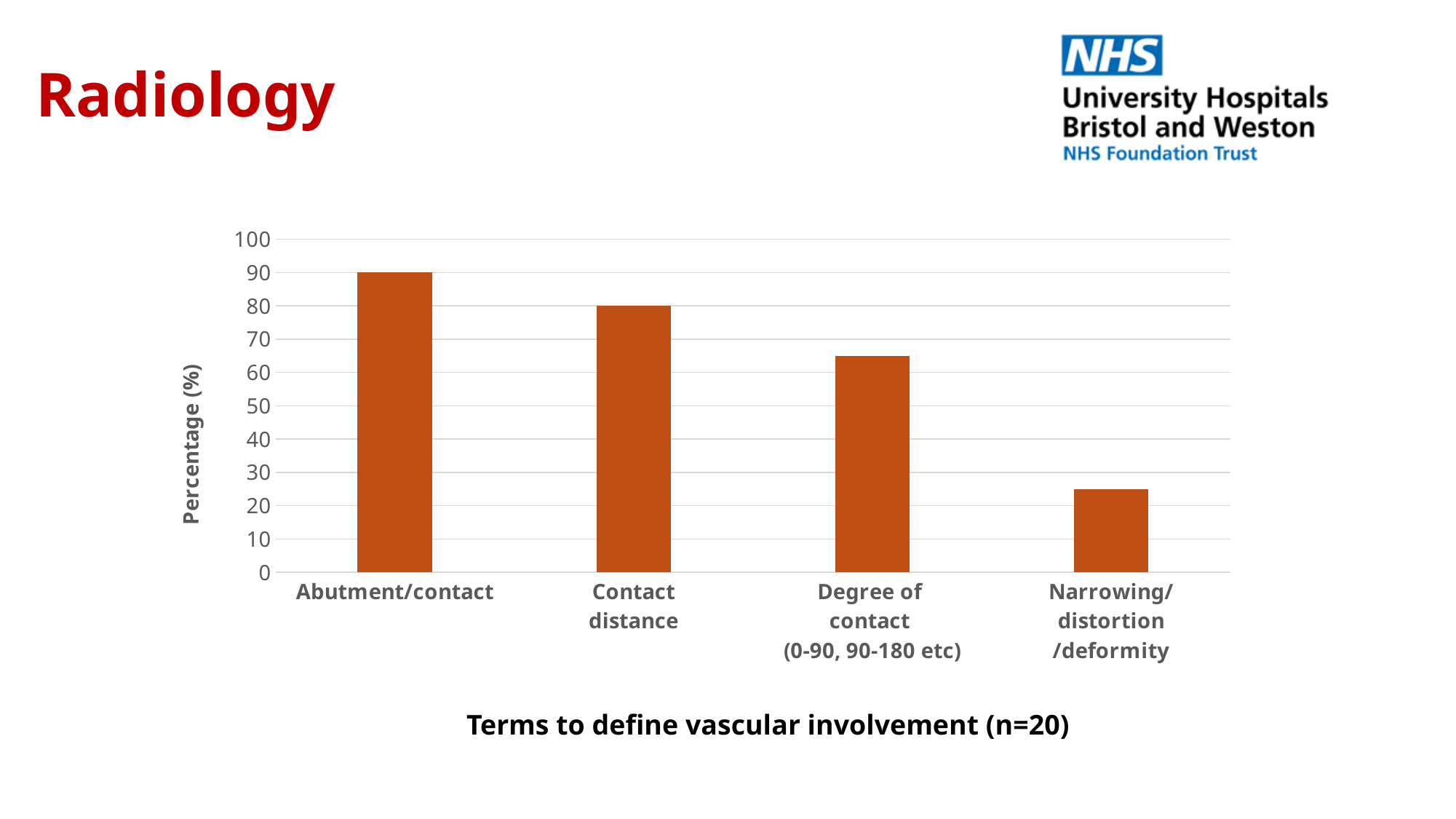
How many categories are shown on the x axis of the chart? 4 Which category has the highest percentage? Abutment/contact What is the label of the y axis? Percentage (%) Which category has the lowest percentage? Narrowing/distortion/deformity What is the percentage for Abutment/contact? 90 Is the value for Narrowing/distortion/deformity greater or less than 30? less Which has a higher percentage, Contact distance or Degree of contact (0-90, 90-180 etc)? Contact distance What type of chart is shown on the slide? Bar chart What is the difference in percentage between Abutment/contact and Contact distance? 10 What is the percentage for Contact distance? 80 Is the value for Degree of contact (0-90, 90-180 etc) greater or less than 60? greater Do the bar values rise or fall from left to right along the x axis? Fall